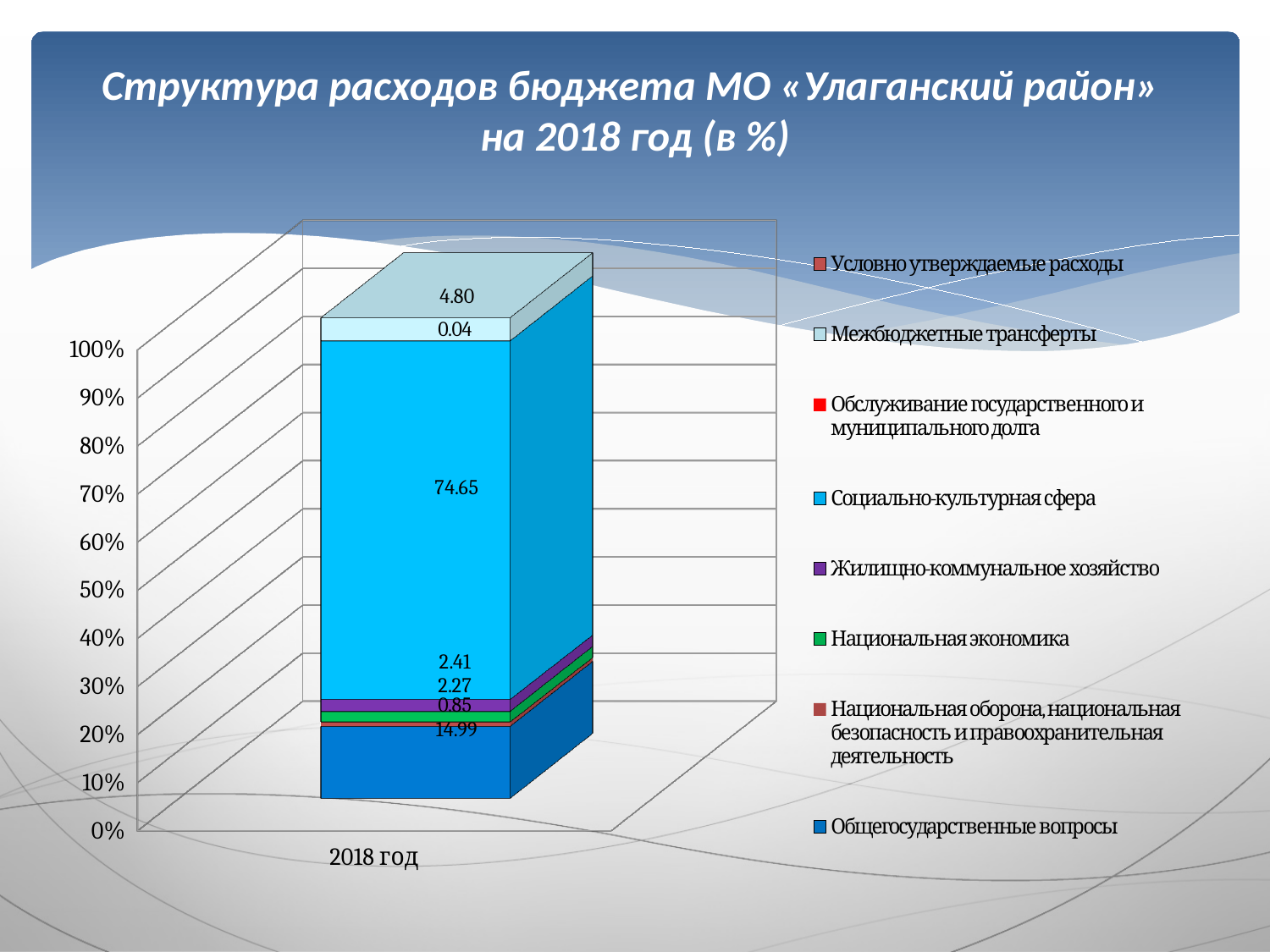
Which series has the largest share of the 2018 budget expenditure? Социально-культурная сфера What type of chart is shown on the slide? Stacked bar chart What is the value for Межбюджетные трансферты? 4.80 Which is larger, the value for Жилищно-коммунальное хозяйство or the value for Национальная экономика? Жилищно-коммунальное хозяйство How many categories are shown on the x axis? 1 What is the value for Жилищно-коммунальное хозяйство? 2.41 What is the value for Национальная экономика? 2.27 How many series does the legend list? 8 What is the difference between the values for Социально-культурная сфера and Общегосударственные вопросы? 59.66 What is the value for Социально-культурная сфера? 74.65 What is the x-axis category label of the bar? 2018 год What is the value for Общегосударственные вопросы? 14.99